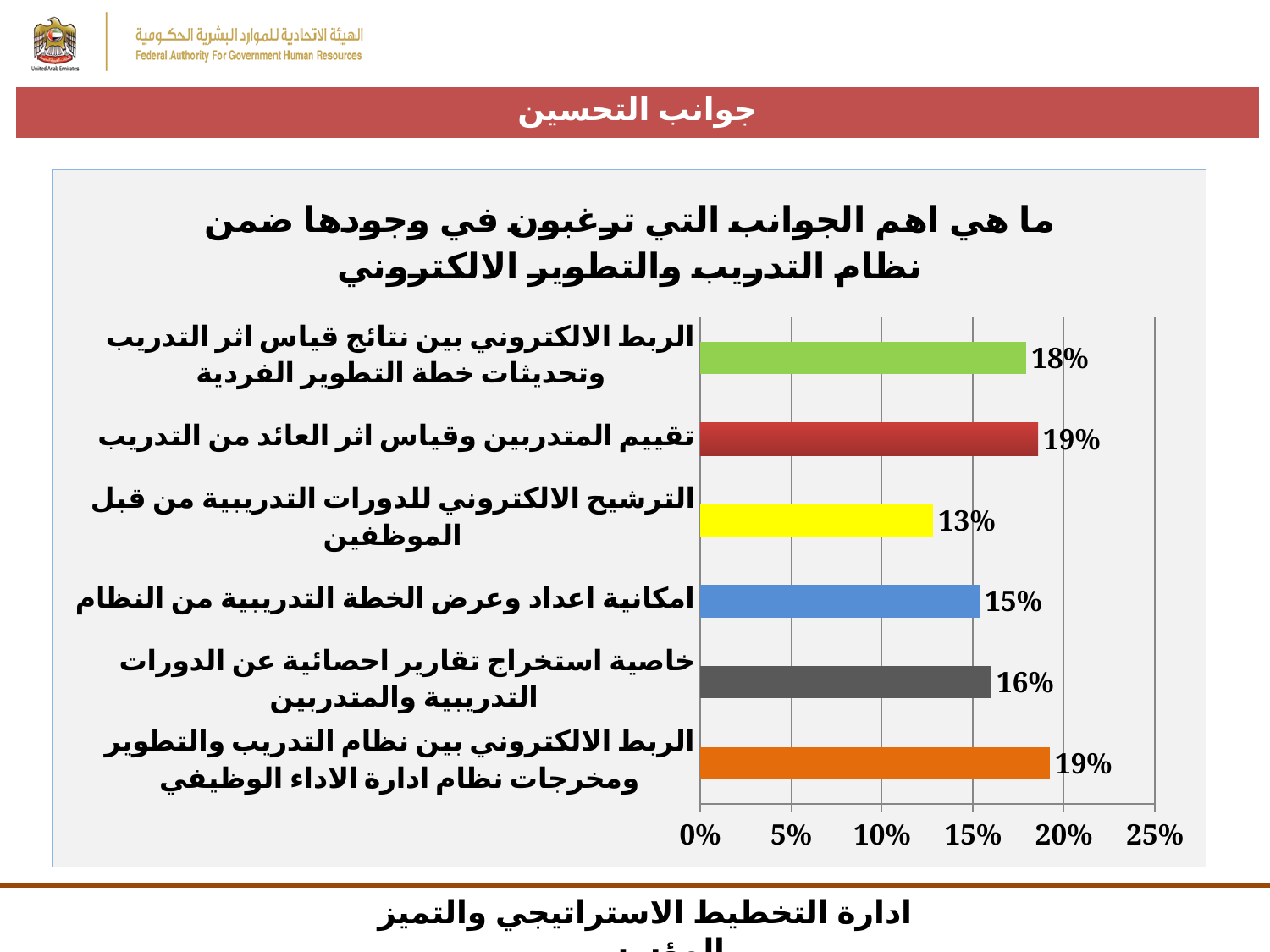
Which is larger: the value for "خاصية استخراج تقارير احصائية عن الدورات التدريبية والمتدربين" or the value for "الترشيح الالكتروني للدورات التدريبية من قبل الموظفين"? خاصية استخراج تقارير احصائية عن الدورات التدريبية والمتدربين What value is shown for "امكانية اعداد وعرض الخطة التدريبية من النظام"? 15% What is the difference between the values for "الربط الالكتروني بين نتائج قياس اثر التدريب وتحديثات خطة التطوير الفردية" and "امكانية اعداد وعرض الخطة التدريبية من النظام"? 3% How many categories are shown in the chart? 6 What value is shown for "الترشيح الالكتروني للدورات التدريبية من قبل الموظفين"? 13% Is the value for "الربط الالكتروني بين نظام التدريب والتطوير ومخرجات نظام ادارة الاداء الوظيفي" greater or less than 15%? greater What kind of chart is shown on the slide? bar chart What is the difference between the values for "تقييم المتدربين وقياس اثر العائد من التدريب" and "الترشيح الالكتروني للدورات التدريبية من قبل الموظفين"? 6% What is the maximum value shown on the chart's horizontal axis? 25% What value is shown for "الربط الالكتروني بين نتائج قياس اثر التدريب وتحديثات خطة التطوير الفردية"? 18% Which category has the lowest value? الترشيح الالكتروني للدورات التدريبية من قبل الموظفين What value is shown for "خاصية استخراج تقارير احصائية عن الدورات التدريبية والمتدربين"? 16%